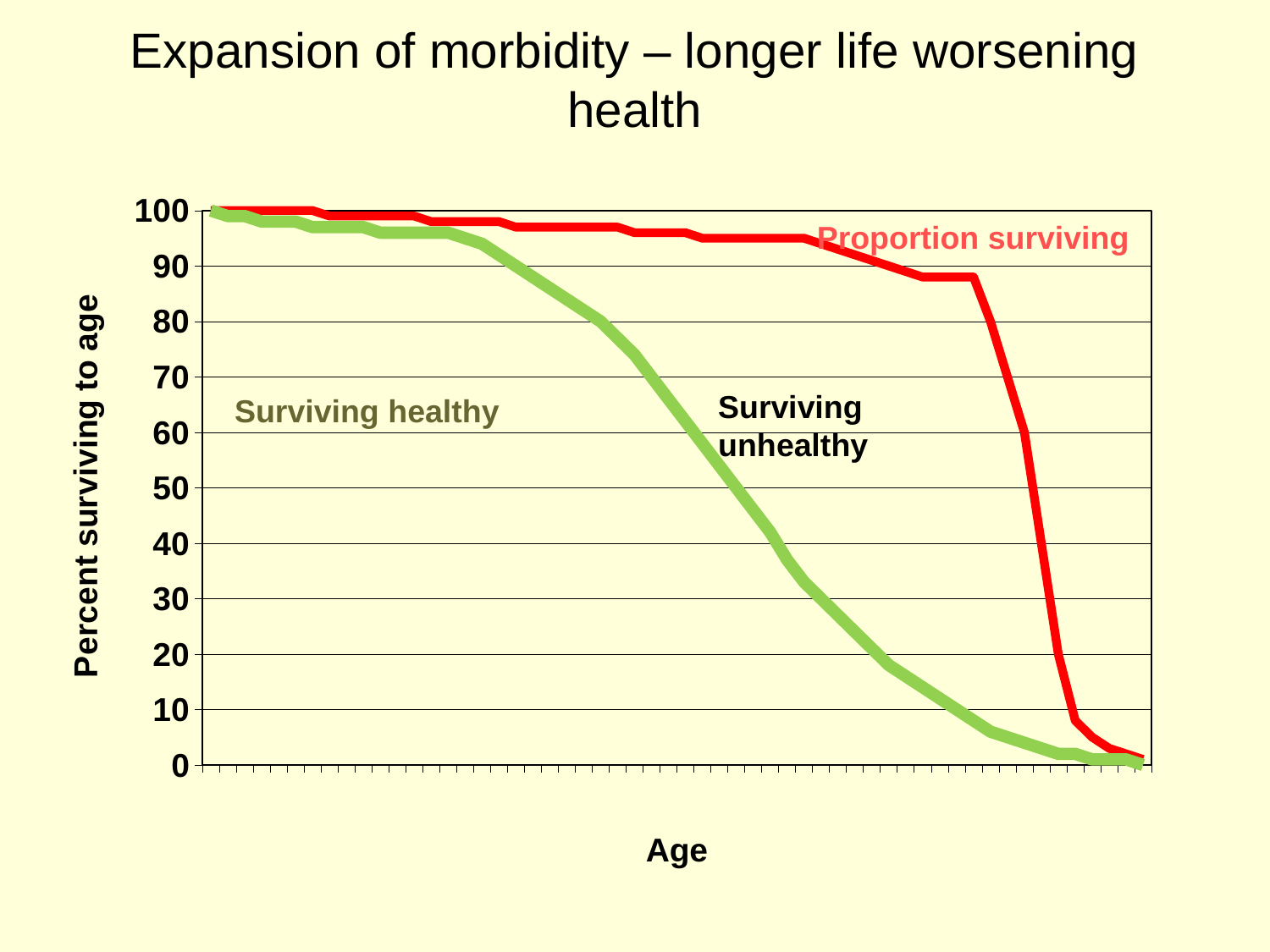
Does the Surviving healthy line rise or fall as age increases along the x axis? fall What kind of chart is shown on the slide? line chart At the right end of the Age axis, is the value of the Surviving healthy line greater or less than 10? less What is the title of the slide? Expansion of morbidity – longer life worsening health Which line is higher across the chart, Proportion surviving or Surviving healthy? Proportion surviving What is the highest value shown on the vertical axis? 100 Does the Proportion surviving line rise or fall as age increases along the x axis? fall At the left end of the Age axis, is the value of the Surviving healthy line greater or less than 90? greater What is the label of the vertical axis? Percent surviving to age How many lines are plotted on the chart? 2 What is the lowest value shown on the vertical axis? 0 At the left end of the Age axis, is the value of the Proportion surviving line greater or less than 90? greater